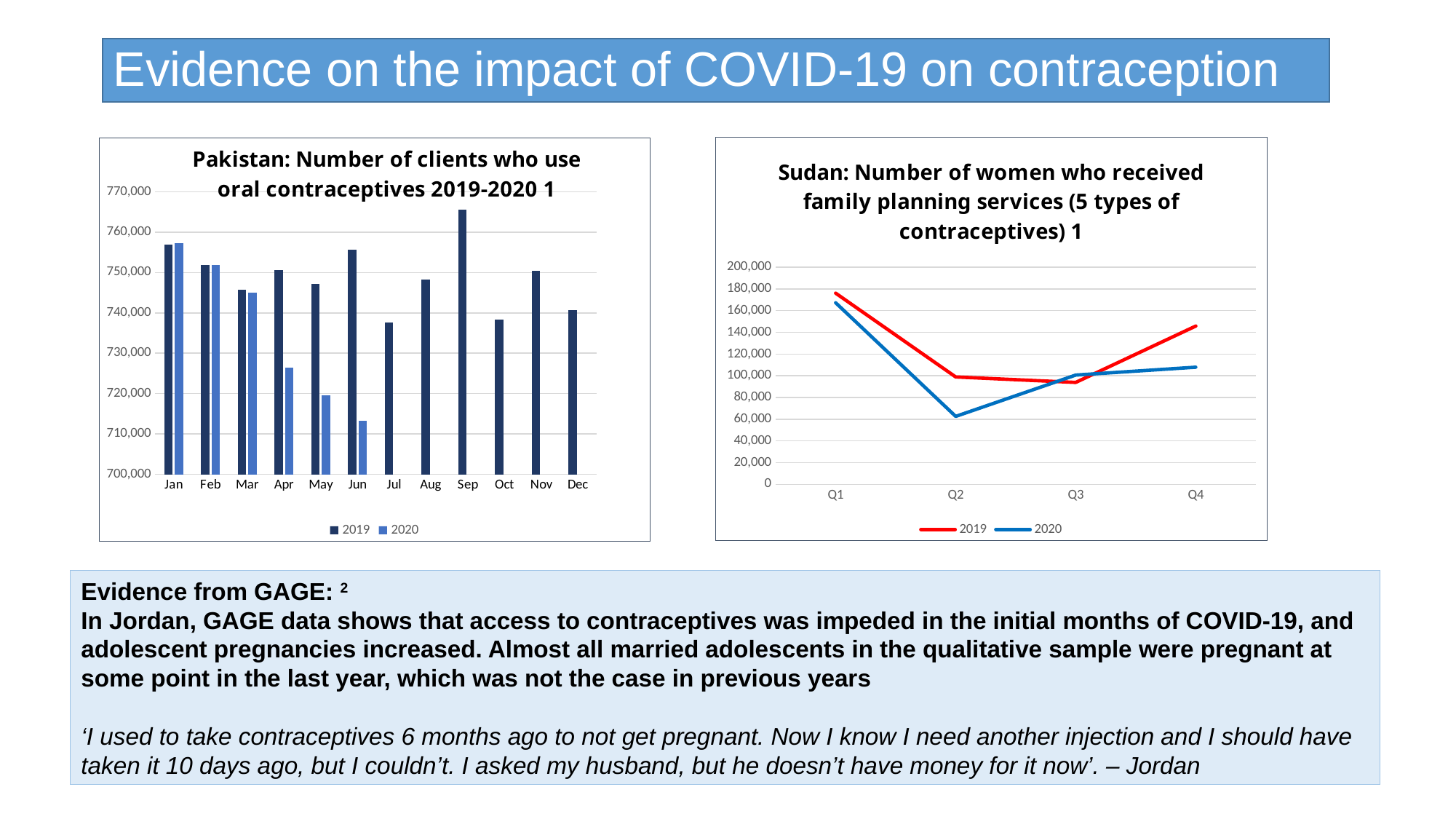
In the Sudan chart, is the 2020 value for Q2 greater or less than 80,000? less In the Sudan chart, which quarter has the lowest 2020 value? Q2 In the Pakistan chart, is the 2020 value for Jun greater or less than 720,000? less What kind of chart is the Pakistan chart on the left? bar chart In the Sudan chart, which series has the larger value at Q4, 2019 or 2020? 2019 In the Pakistan chart, which month has the highest 2019 value? Sep In the Pakistan chart, how many series does the legend list? 2 In the Pakistan chart, which month has the lowest 2020 value? Jun What kind of chart is the Sudan chart on the right? line chart In the Sudan chart, which quarter has the highest 2019 value? Q1 In the Pakistan chart, is the 2019 value for Sep greater or less than 760,000? greater In the Pakistan chart, how many months are shown on the x axis? 12